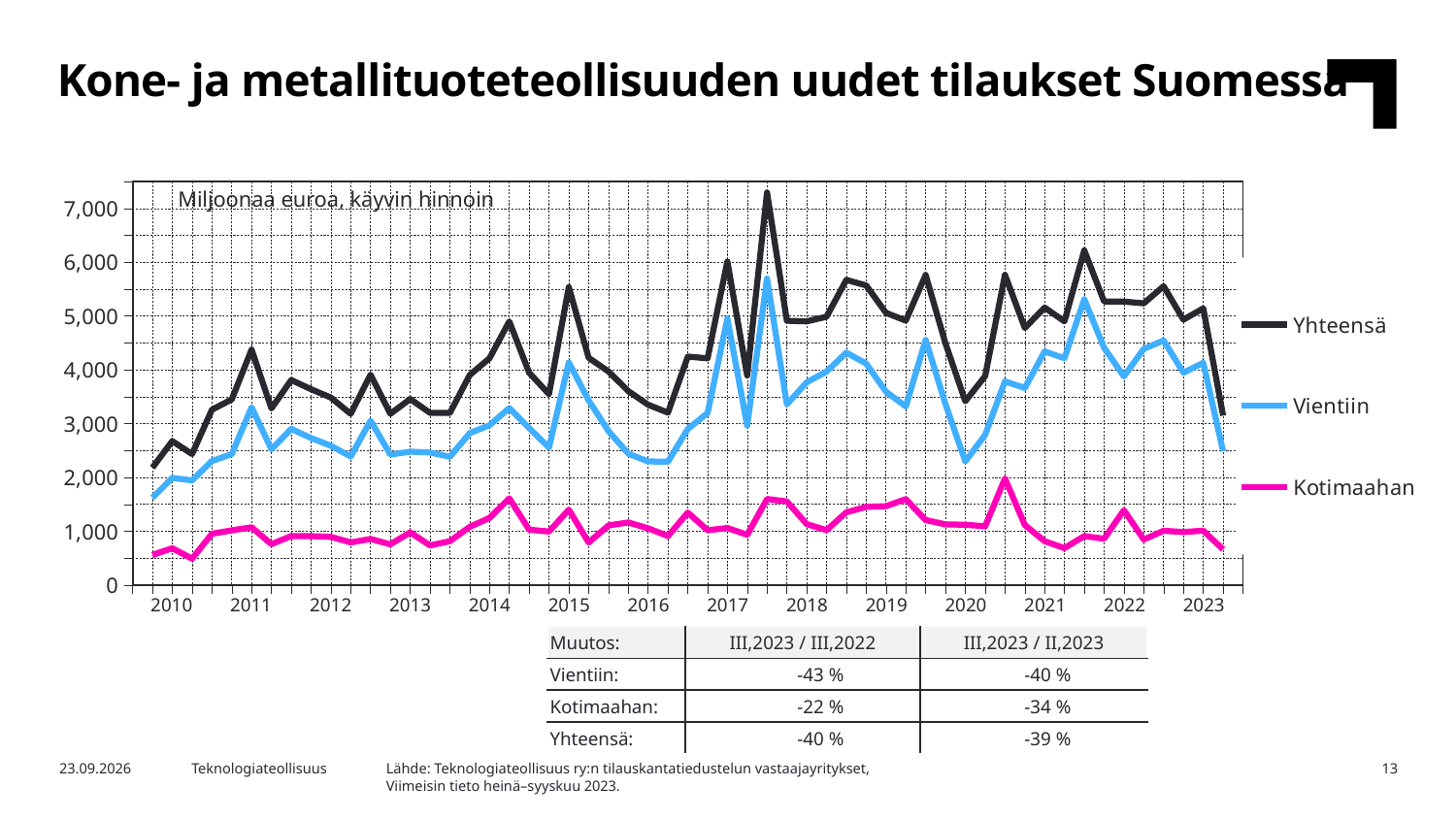
Is the highest peak of the Vientiin line greater or less than 5,000? greater Is the first value of the Kotimaahan line in 2010 greater or less than 1,000? less How many years are labelled on the x axis of the chart? 14 What are the three series named in the chart legend? Yhteensä, Vientiin, Kotimaahan Which series has the highest values throughout the chart? Yhteensä Which series has the lowest values throughout the chart? Kotimaahan How many series does the chart legend list? 3 Is the last value of the Vientiin line in 2023 greater or less than 3,000? less In which year does the Yhteensä line reach its highest peak? 2017 What kind of chart is shown on the slide? line chart What unit is stated in the label inside the chart area? Miljoonaa euroa, käyvin hinnoin